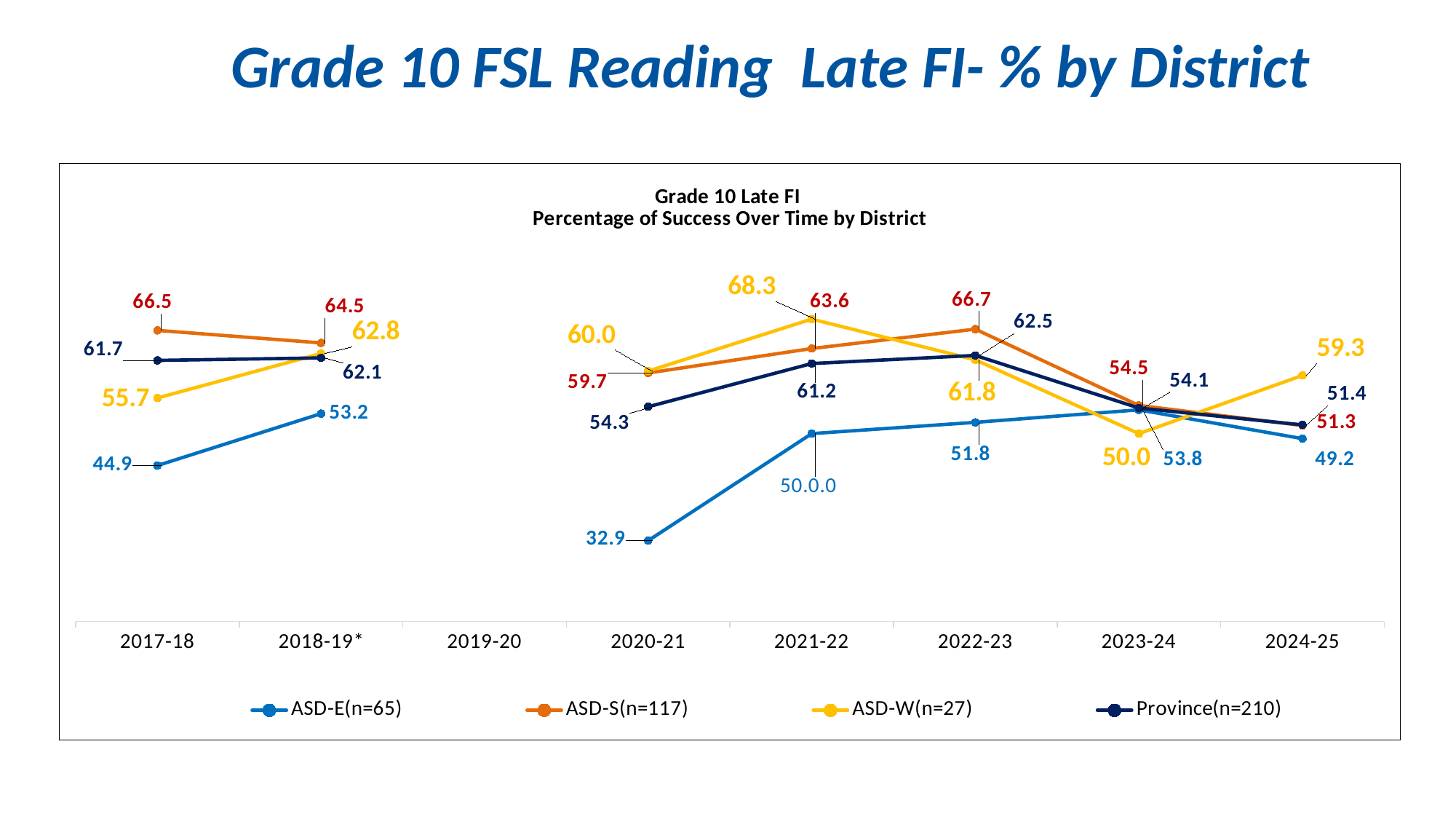
What is the difference between ASD-S(n=117) and ASD-E(n=65) in 2017-18? 21.6 Which is larger in 2024-25, ASD-W(n=27) or ASD-E(n=65)? ASD-W(n=27) Does the ASD-E(n=65) line rise or fall from 2017-18 to 2018-19*? Rise Which series has the lowest value in 2023-24? ASD-W(n=27) What is the value for Province(n=210) in 2024-25? 51.4 Which series has the highest value in 2022-23? ASD-S(n=117) How many series does the legend list? 4 What is the value for ASD-E(n=65) in 2020-21? 32.9 How many school-year categories are shown on the x axis? 8 What kind of chart is this? Line chart What is the value for ASD-W(n=27) in 2021-22? 68.3 What is the value for ASD-S(n=117) in 2017-18? 66.5